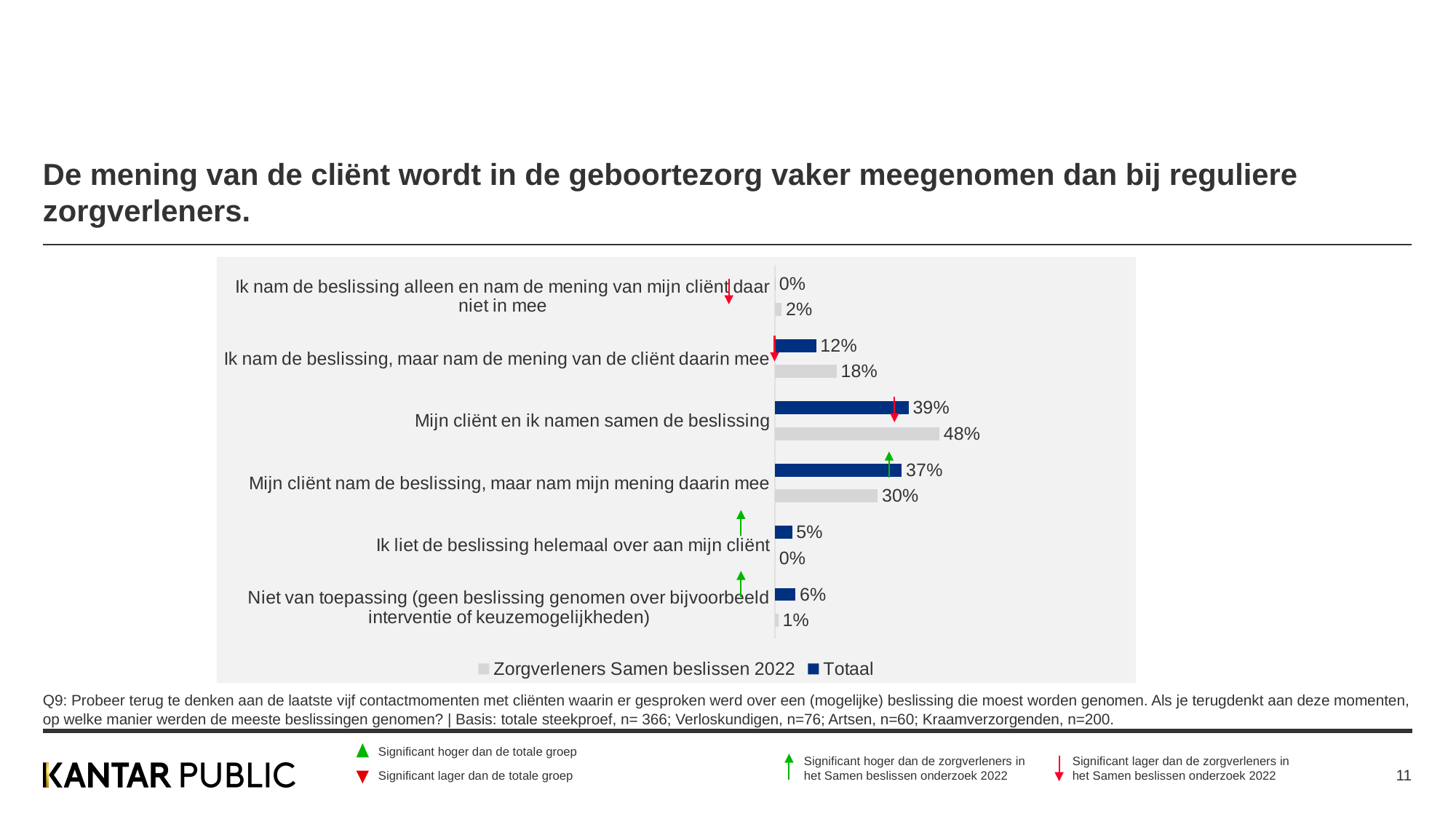
What is the Totaal value for "Mijn cliënt en ik namen samen de beslissing"? 39% Which category has the highest Totaal value? Mijn cliënt en ik namen samen de beslissing Which category has the lowest Totaal value? Ik nam de beslissing alleen en nam de mening van mijn cliënt daar niet in mee How many series does the legend list? 2 What is the difference between the Zorgverleners Samen beslissen 2022 value and the Totaal value for "Mijn cliënt en ik namen samen de beslissing"? 9% What is the Zorgverleners Samen beslissen 2022 value for "Mijn cliënt nam de beslissing, maar nam mijn mening daarin mee"? 30% What kind of chart is shown on the slide? Bar chart How many categories are shown in the chart? 6 What is the Totaal value for "Ik nam de beslissing, maar nam de mening van de cliënt daarin mee"? 12% What is the Zorgverleners Samen beslissen 2022 value for "Mijn cliënt en ik namen samen de beslissing"? 48% For "Ik nam de beslissing, maar nam de mening van de cliënt daarin mee", which series has the larger value: Totaal or Zorgverleners Samen beslissen 2022? Zorgverleners Samen beslissen 2022 What is the difference between the Totaal value and the Zorgverleners Samen beslissen 2022 value for "Mijn cliënt nam de beslissing, maar nam mijn mening daarin mee"? 7%